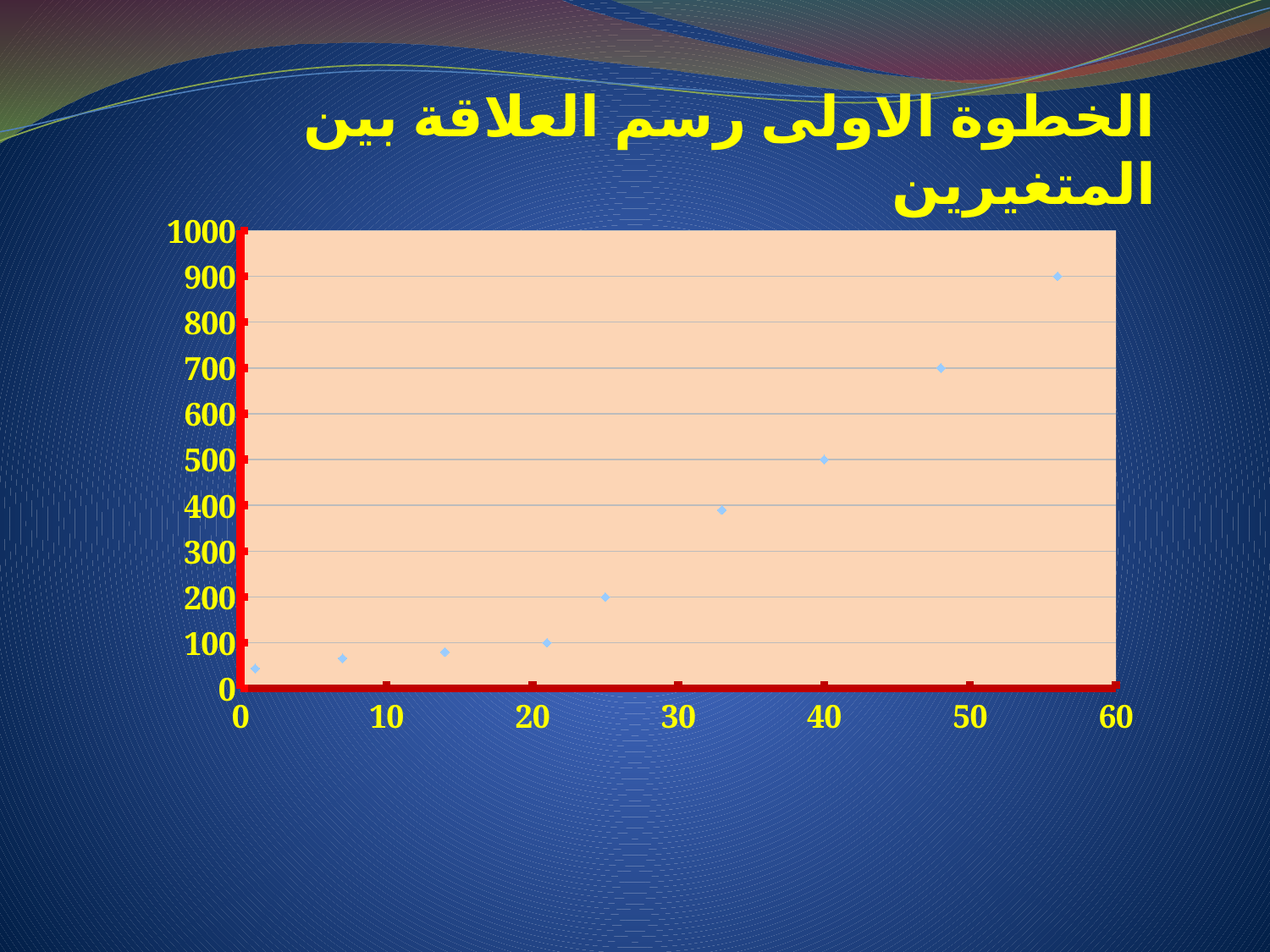
Is the highest point located at the left end or the right end of the x axis? right end Is the lowest point located at the left end or the right end of the x axis? left end What is the maximum value shown on the y axis? 1000 Is the value of the point nearest x = 40 greater or less than 400? greater Is the value of the rightmost point greater or less than 800? greater What kind of chart is shown on the slide? scatter chart Is the value of the point nearest x = 50 greater or less than 600? greater What is the maximum value shown on the x axis? 60 Do the plotted values rise or fall as x increases along the x axis? rise How many data points are plotted on the chart? 9